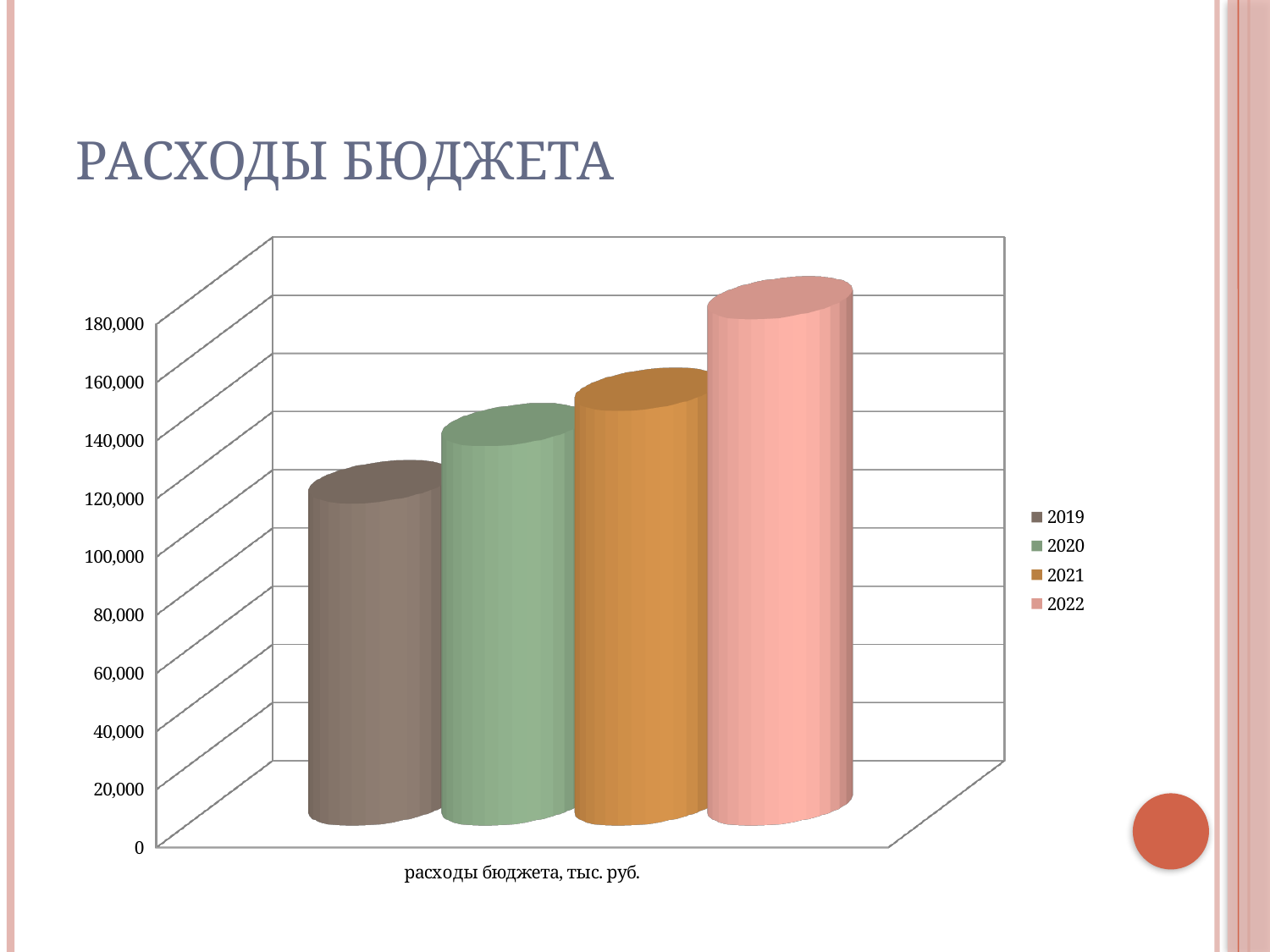
Which year has the lowest budget expenditure bar? 2019 Is the value for 2019 greater or less than 100,000? greater Is the value for 2022 greater or less than 160,000? greater How many series does the legend list? 4 Is the value for 2019 greater or less than 140,000? less Which year has the highest budget expenditure bar? 2022 What is the label shown under the x axis of the chart? расходы бюджета, тыс. руб. Which is larger, the value for 2020 or the value for 2021? 2021 Do the bars rise or fall from 2019 to 2022? rise What kind of chart is shown on the slide? bar chart